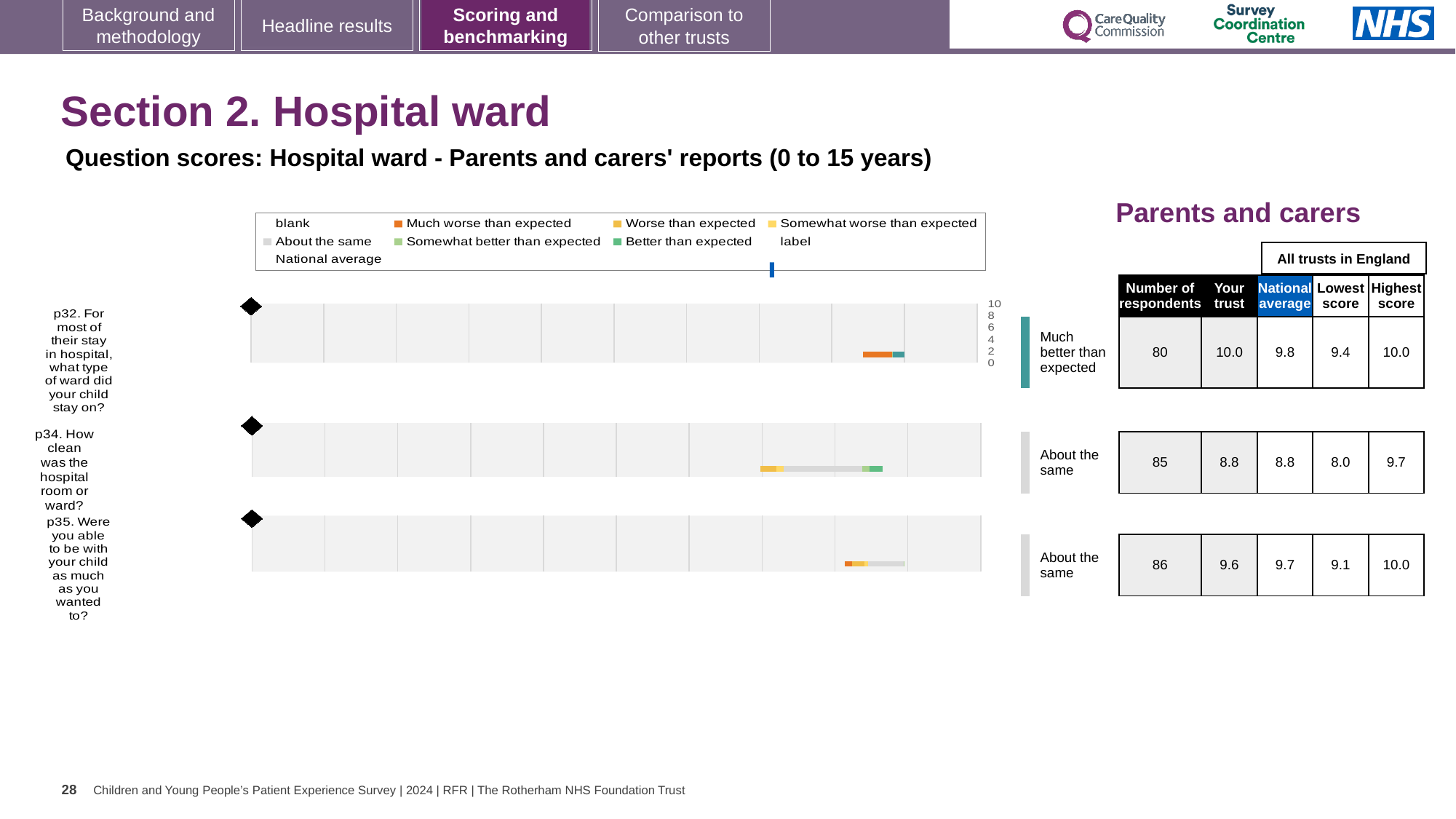
Which question has the highest number of respondents in the table? p35 What is the title of the table to the right of the charts? Parents and carers What kind of chart is used to show the question scores on this slide? bar chart How many entries does the chart legend list? 9 In the table, what is the national average for p34 (how clean was the hospital room or ward)? 8.8 In the table, what is the 'Your trust' score for p32 (what type of ward did your child stay on)? 10.0 How many questions (p32, p34, p35) are plotted as bars on the slide? 3 What benchmark category is shown next to the p32 bar? Much better than expected In the table, how many respondents answered p35 (were you able to be with your child as much as you wanted to)? 86 What is the difference between the highest score and the lowest score for p34 in the table? 1.7 For p32, is the 'Your trust' score larger or smaller than the national average? larger Which legend entry is shown in orange? Much worse than expected